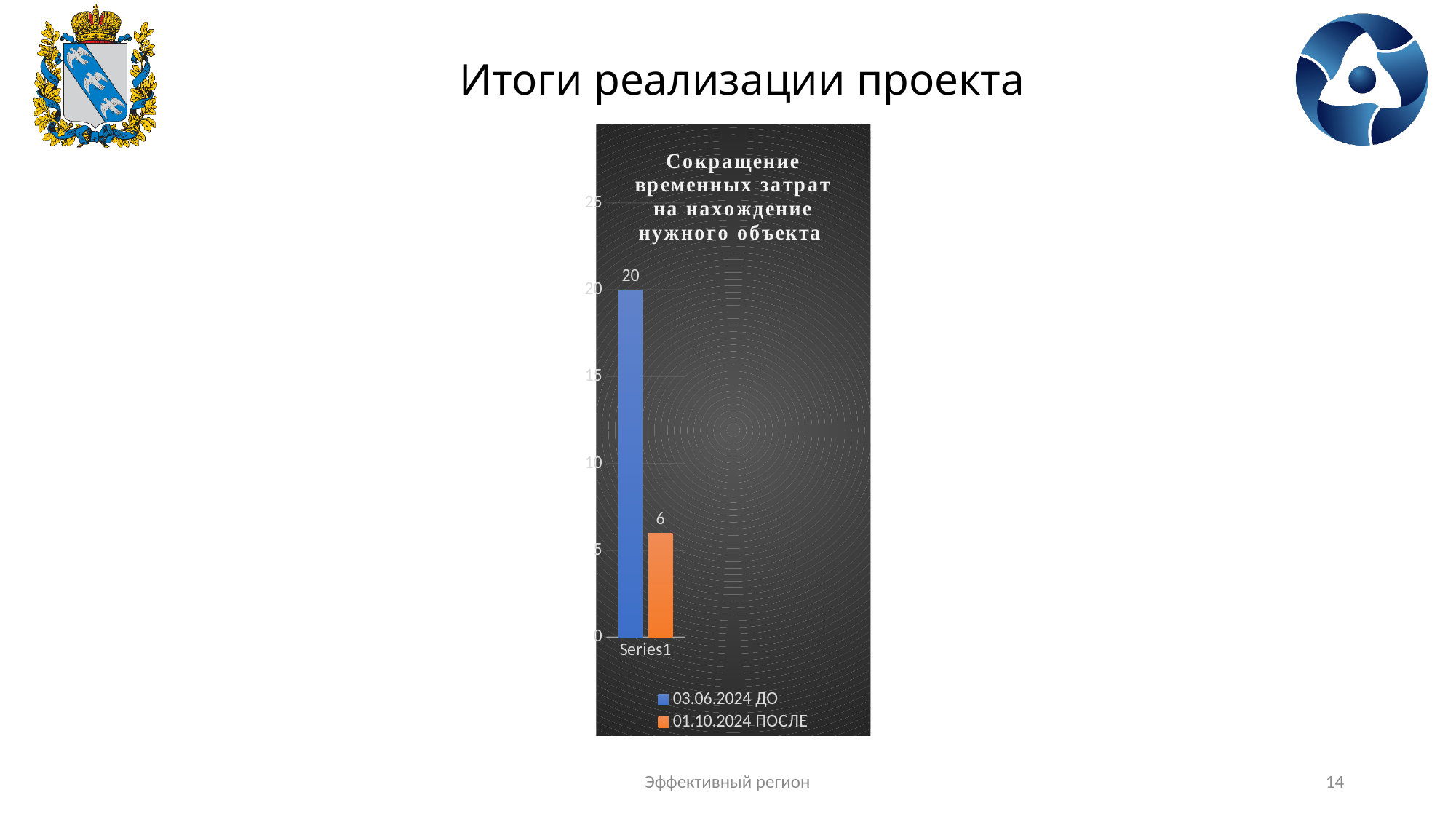
What kind of chart is shown on the slide? Bar chart How many series does the legend list? 2 Which series has the higher value, "03.06.2024 ДО" or "01.10.2024 ПОСЛЕ"? 03.06.2024 ДО What is the difference between the "03.06.2024 ДО" value and the "01.10.2024 ПОСЛЕ" value? 14 Is the value for "01.10.2024 ПОСЛЕ" greater or less than 10? less Which series has the lowest value? 01.10.2024 ПОСЛЕ What is the value for the series "01.10.2024 ПОСЛЕ"? 6 What is the title of the chart? Сокращение временных затрат на нахождение нужного объекта What is the value for the series "03.06.2024 ДО"? 20 Is the value for "03.06.2024 ДО" greater or less than 15? greater What colour is the bar for "01.10.2024 ПОСЛЕ"? Orange What is the highest value shown on the vertical axis? 25